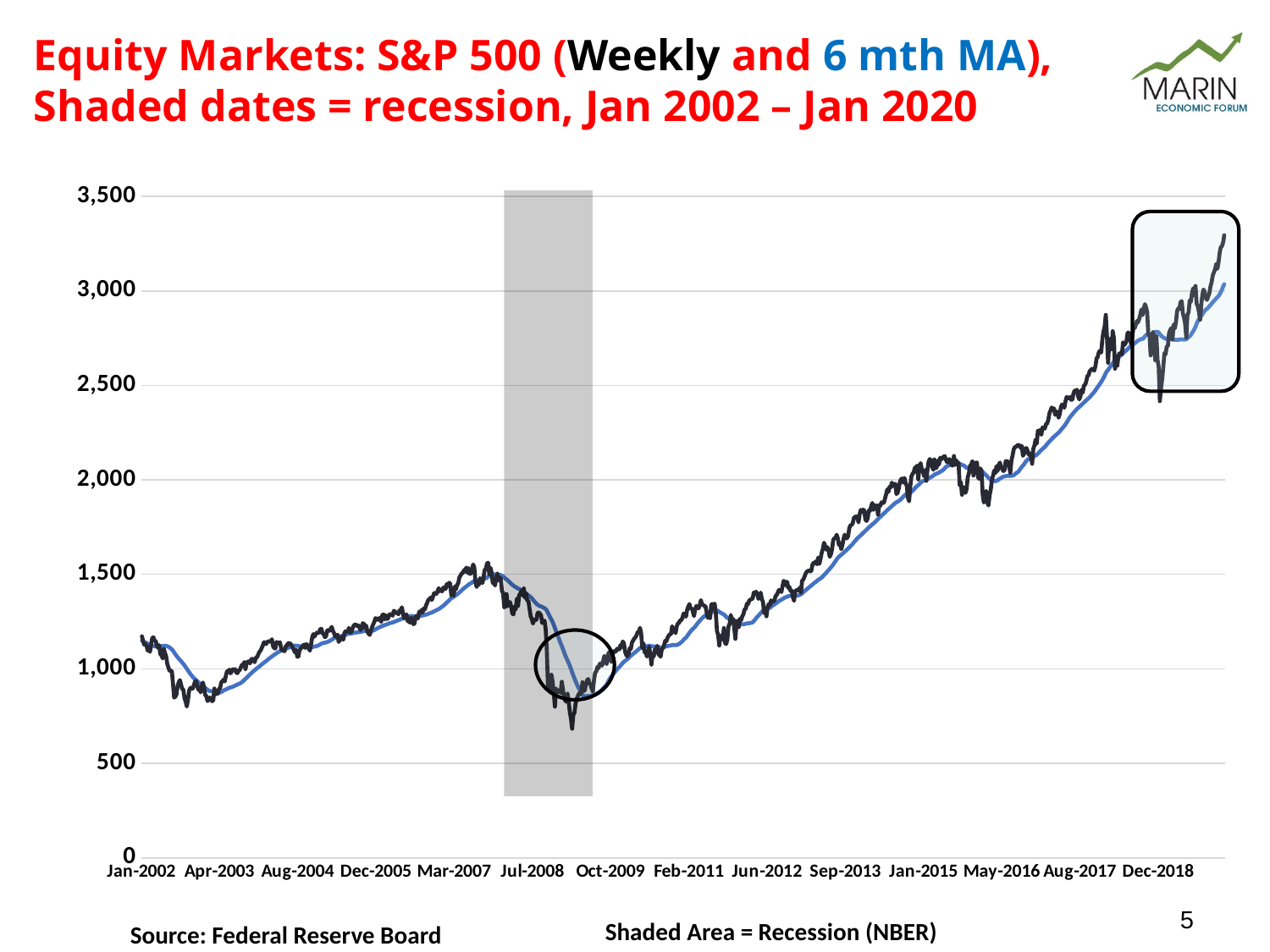
Overall, does the S&P 500 rise or fall from Jan-2002 to the end of the chart? Rise Is the lowest S&P 500 value during the shaded recession greater or less than 1,000? less What kind of chart is shown on the slide? Line chart What is the source of the data shown in the chart? Federal Reserve Board How many date labels are shown on the x axis? 14 Within the shaded recession area, does the S&P 500 rise or fall? Fall Is the S&P 500 value at Jan-2002 greater or less than 1,000? greater Is the S&P 500 value at Jun-2012 greater or less than 1,500? less What is the highest value labelled on the y axis? 3,500 How many data series does the chart plot, according to the title? 2